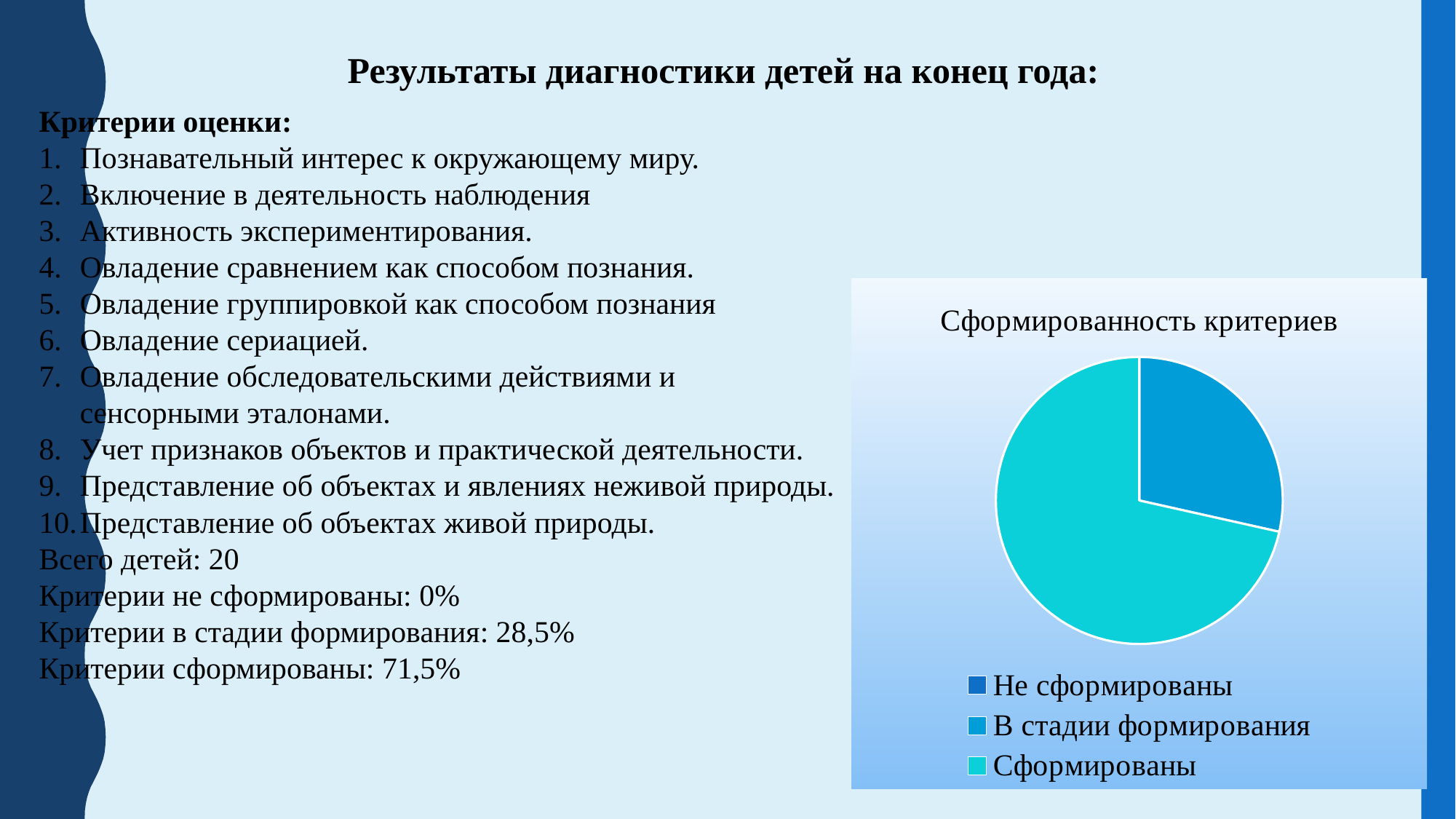
What is the title of the chart? Сформированность критериев Which category takes up the largest share of the pie? Сформированы Which category has the smallest share in the chart? Не сформированы How many categories does the chart's legend list? 3 According to the slide, what share corresponds to 'Критерии не сформированы'? 0% According to the slide, what share corresponds to 'Критерии в стадии формирования'? 28,5% Is the share of the 'Сформированы' slice greater or less than 50%? greater What is the difference between the 'Сформированы' share and the 'В стадии формирования' share given on the slide? 43% According to the slide, what share of children have the criteria formed ('Критерии сформированы')? 71,5% Which legend entry is shown in the lightest (turquoise) colour? Сформированы Which slice is larger: 'В стадии формирования' or 'Сформированы'? Сформированы What kind of chart is shown on the slide? pie chart